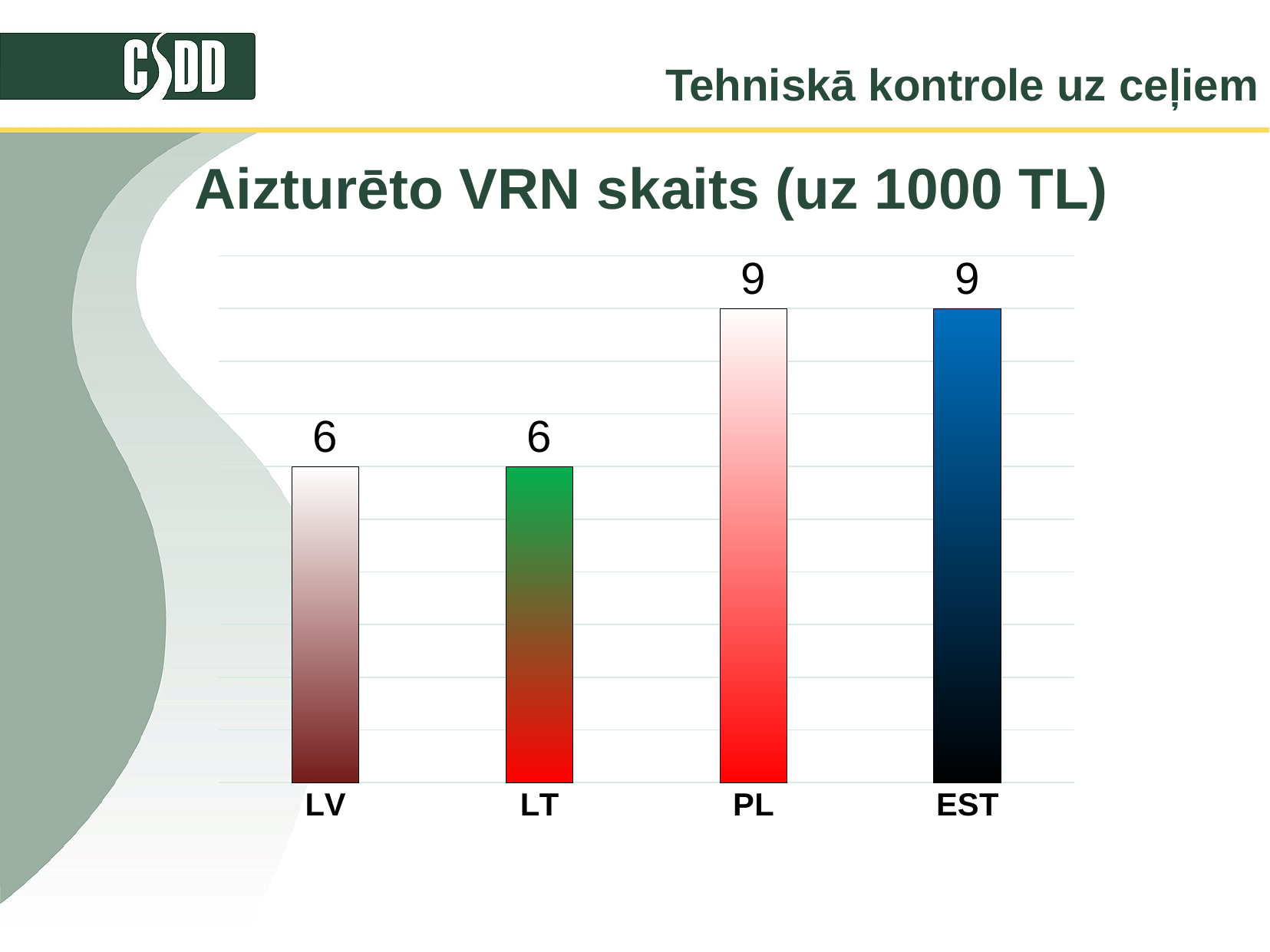
What is the value for PL? 9 What is the difference between the values for PL and LV? 3 What kind of chart is shown on the slide? Bar chart Which categories share the highest value? PL and EST Do the values rise or fall going from LV to EST along the x axis? Rise What is the value for LT? 6 Which is larger, the value for EST or the value for LT? EST Which categories share the lowest value? LV and LT What is the value for EST? 9 What is the value for LV? 6 How many categories are shown on the chart? 4 What is the title of the chart? Aizturēto VRN skaits (uz 1000 TL)